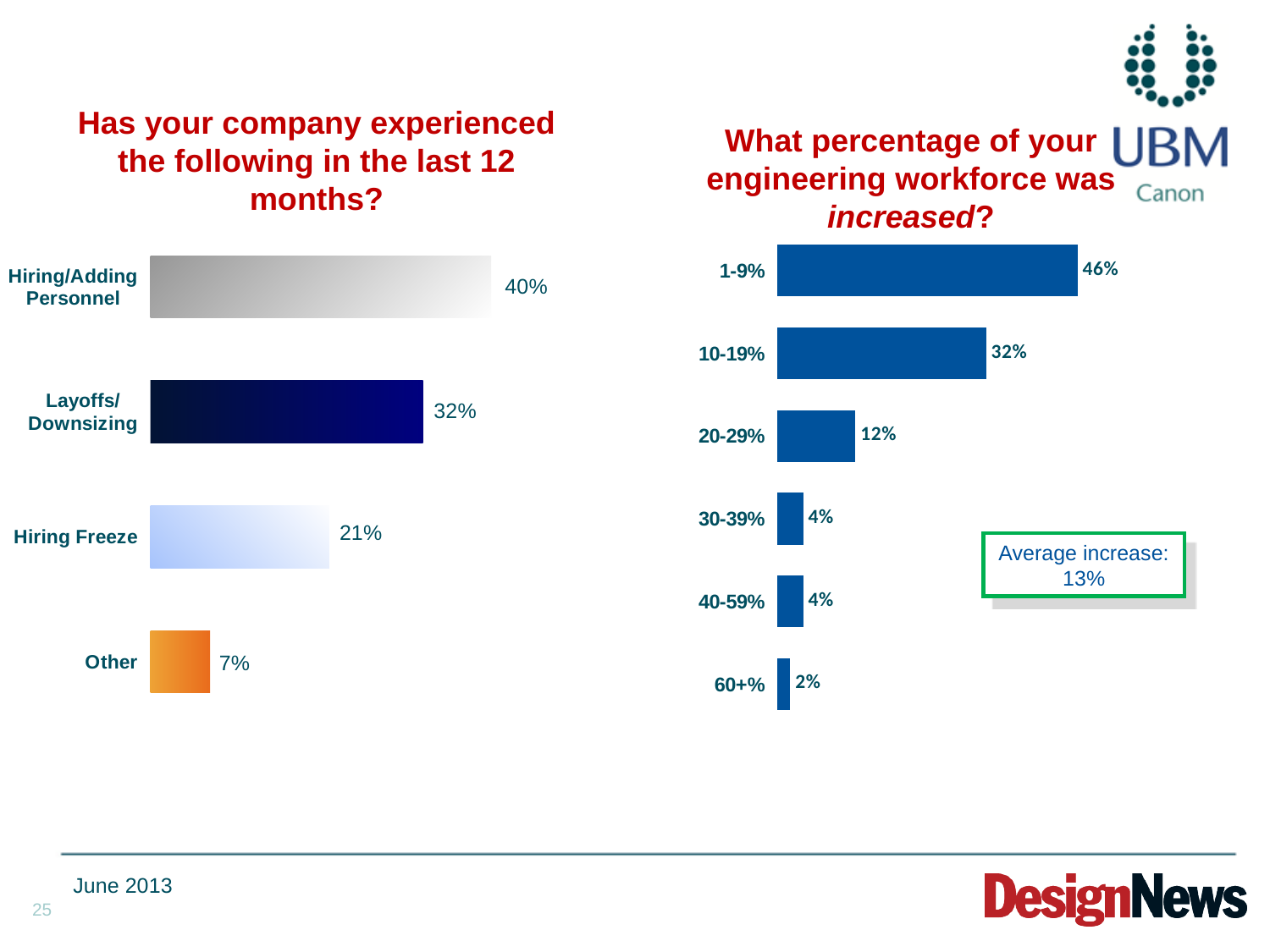
In the right chart ('What percentage of your engineering workforce was increased?'), what is the difference between the 1-9% and 20-29% categories? 34% In the left chart ('Has your company experienced the following in the last 12 months?'), which category has the highest value? Hiring/Adding Personnel In the left chart ('Has your company experienced the following in the last 12 months?'), how many categories are shown? 4 In the right chart ('What percentage of your engineering workforce was increased?'), which category has the highest value? 1-9% What type of chart is the right chart ('What percentage of your engineering workforce was increased?')? Bar chart In the right chart ('What percentage of your engineering workforce was increased?'), how many categories are shown? 6 In the right chart ('What percentage of your engineering workforce was increased?'), what is the value for 10-19%? 32% In the left chart ('Has your company experienced the following in the last 12 months?'), what is the value for Hiring Freeze? 21% In the left chart ('Has your company experienced the following in the last 12 months?'), which category has the lowest value? Other In the left chart ('Has your company experienced the following in the last 12 months?'), what is the difference between Hiring/Adding Personnel and Layoffs/Downsizing? 8% In the right chart ('What percentage of your engineering workforce was increased?'), which category has the lowest value? 60+% In the right chart ('What percentage of your engineering workforce was increased?'), which is larger, the value for 20-29% or the value for 30-39%? 20-29%